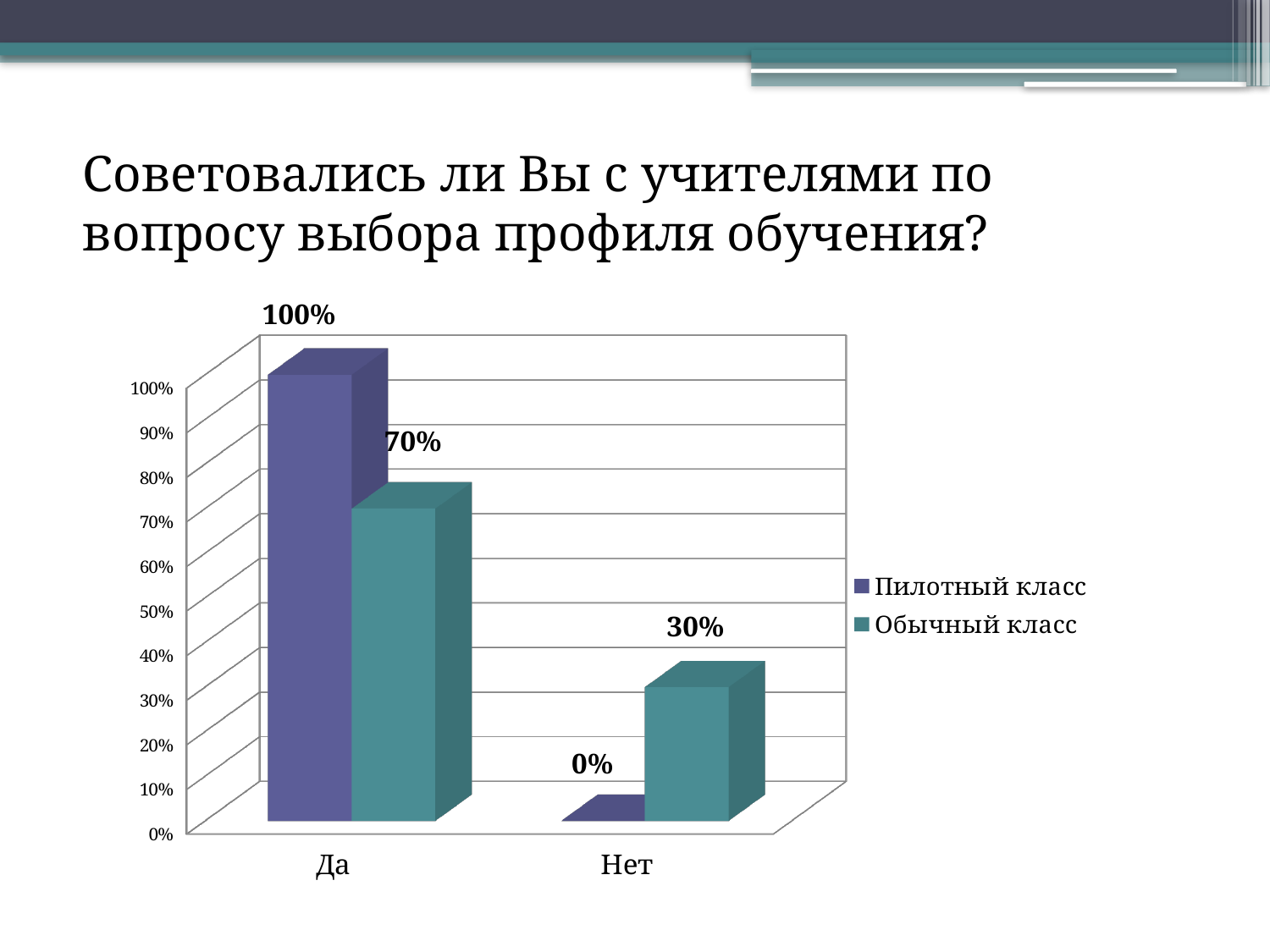
How many categories are shown on the x axis? 2 Which series has the higher value in the Да category? Пилотный класс What is the difference between Пилотный класс and Обычный класс in the Да category? 30% Which category has the lowest value for Обычный класс? Нет What value is shown for Пилотный класс in the Да category? 100% What are the two series names listed in the legend? Пилотный класс, Обычный класс What value is shown for Пилотный класс in the Нет category? 0% What value is shown for Обычный класс in the Да category? 70% What is the difference between the Обычный класс values for Да and Нет? 40% What value is shown for Обычный класс in the Нет category? 30% What kind of chart is shown on the slide? Bar chart How many series does the legend list? 2